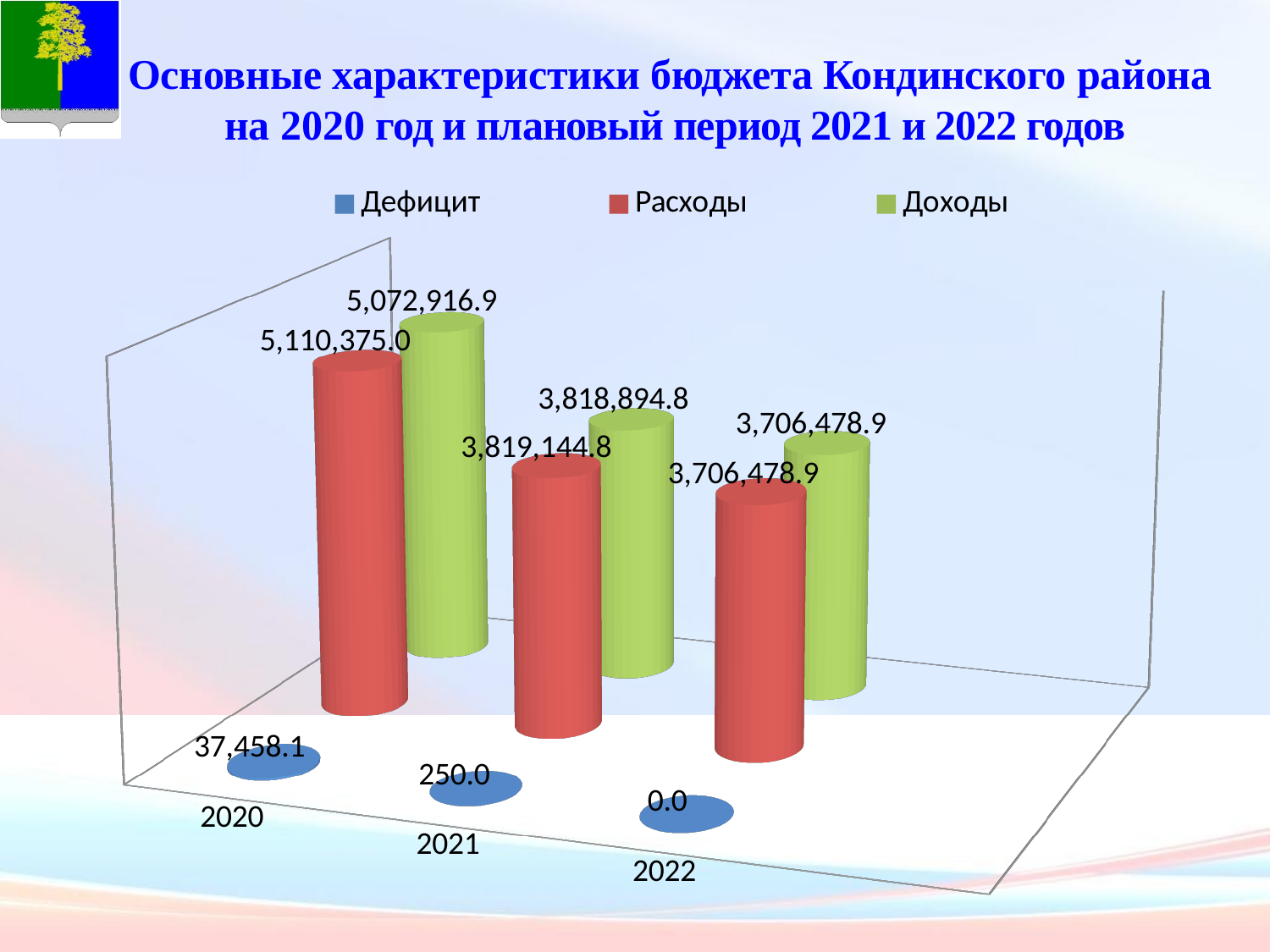
In which year is Дефицит the lowest? 2022 What is the difference between Расходы in 2020 and Расходы in 2021? 1,291,230.2 What is the value of Расходы for 2020? 5,110,375.0 Do the Доходы values rise or fall from 2020 to 2022? fall What is the value of Дефицит for 2020? 37,458.1 What is the difference between Расходы and Доходы in 2020? 37,458.1 In which year is Расходы the highest? 2020 Which is larger in 2021, Расходы or Доходы? Расходы How many series does the legend list? 3 What is the value of Дефицит for 2022? 0.0 How many years are shown on the x axis? 3 What is the value of Доходы for 2021? 3,818,894.8